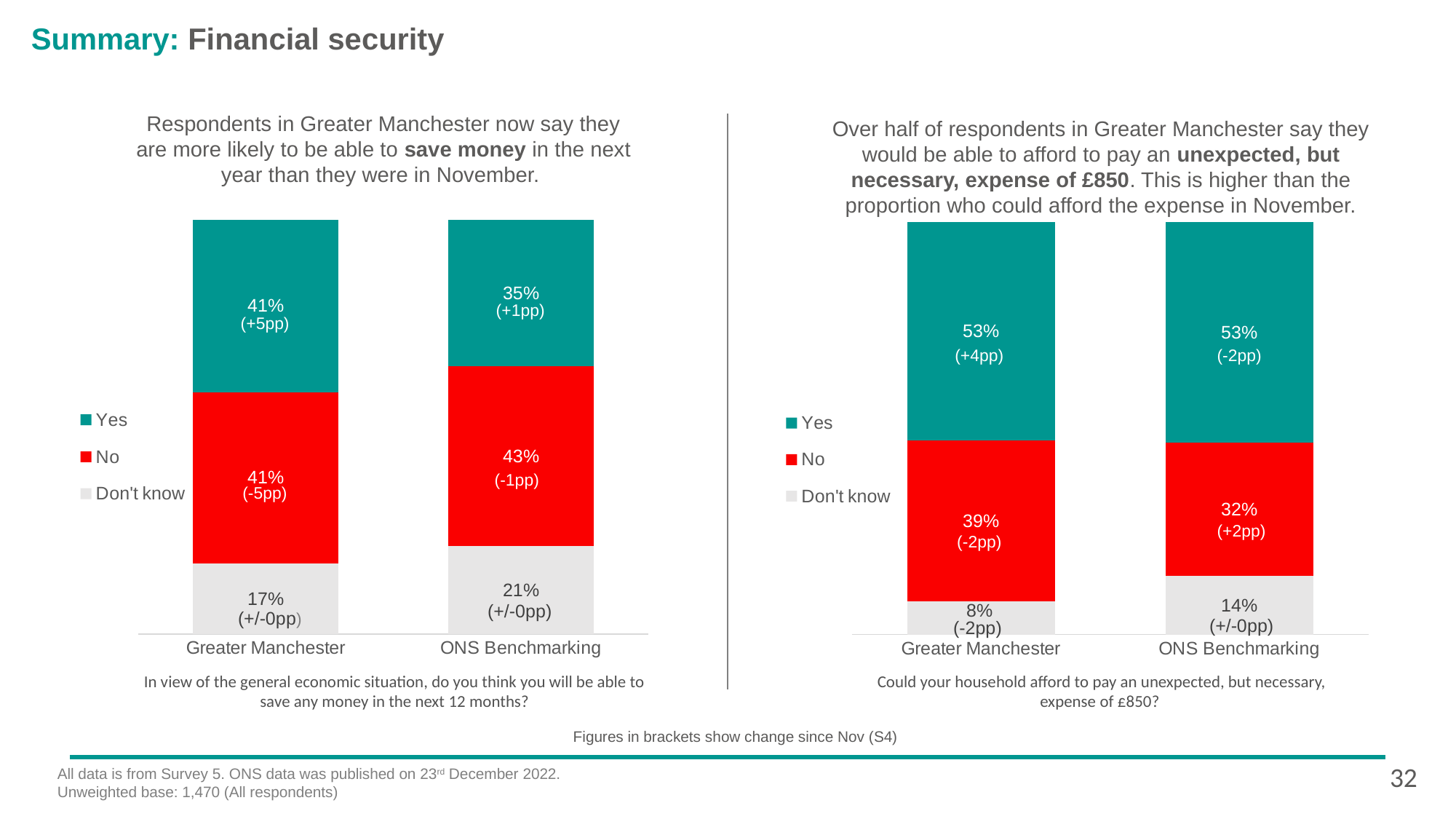
What kind of chart is the left chart (saving money in the next 12 months)? Stacked bar chart How many series does the legend of the left chart list? 3 How many categories are shown on the x axis of the right chart? 2 In the left chart (saving money in the next 12 months), what is the difference between the No values for ONS Benchmarking and Greater Manchester? 2 percentage points In the left chart (saving money in the next 12 months), which has the larger Yes value, Greater Manchester or ONS Benchmarking? Greater Manchester In the right chart (affording an unexpected £850 expense), which has the larger No value, Greater Manchester or ONS Benchmarking? Greater Manchester In the left chart (saving money in the next 12 months), what percentage of Greater Manchester respondents answered Yes? 41% In the right chart (affording an unexpected £850 expense), what is the Don't know value for ONS Benchmarking? 14% In the right chart (affording an unexpected £850 expense), which category has the lowest Don't know value? Greater Manchester In the left chart (saving money in the next 12 months), what is the Don't know value for ONS Benchmarking? 21% In the right chart (affording an unexpected £850 expense), what is the difference between the Don't know values for ONS Benchmarking and Greater Manchester? 6 percentage points In the right chart (affording an unexpected £850 expense), what percentage of Greater Manchester respondents answered No? 39%